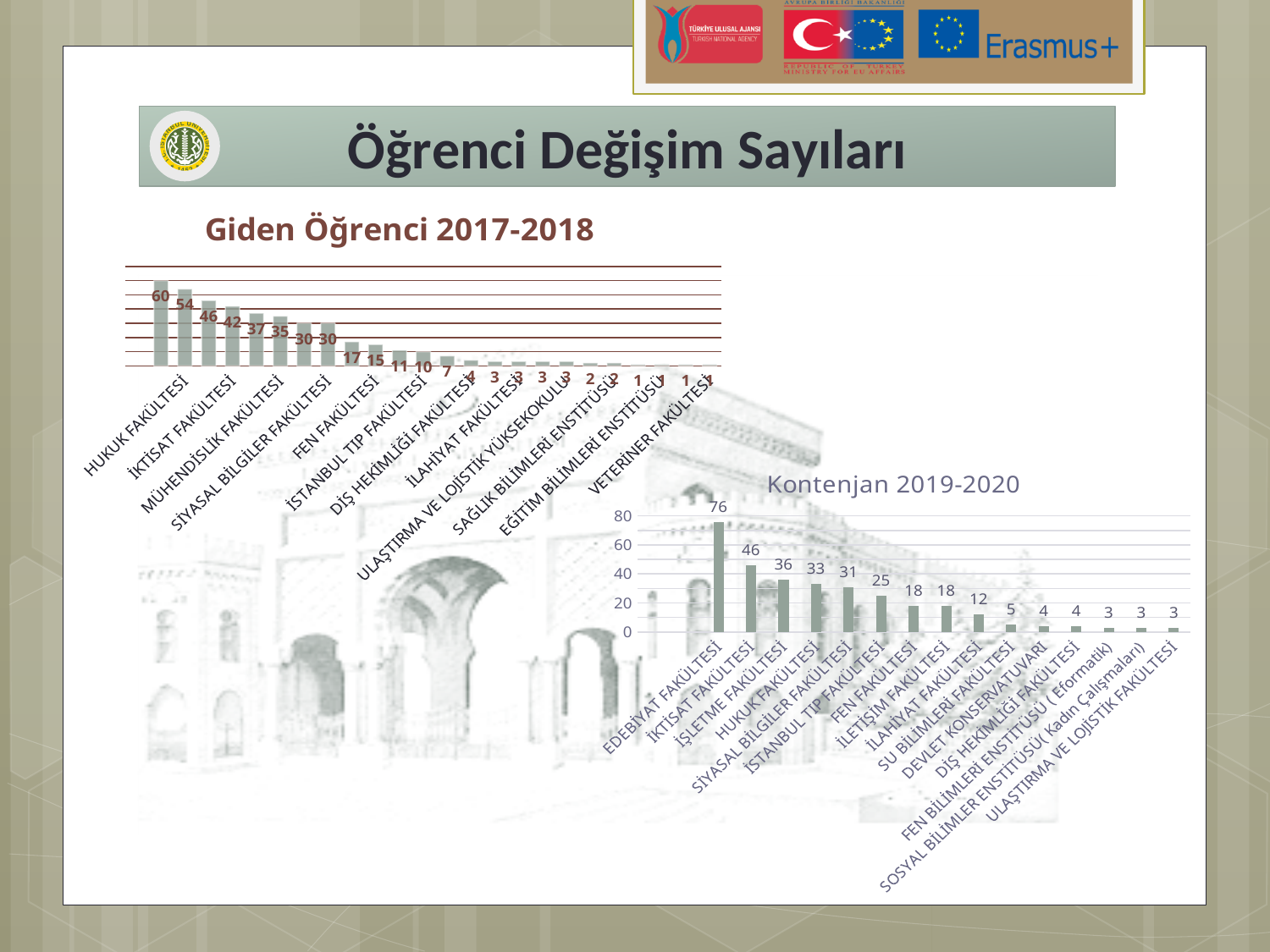
In the 'Kontenjan 2019-2020' chart, what is the difference between EDEBİYAT FAKÜLTESİ and İKTİSAT FAKÜLTESİ? 30 In the 'Kontenjan 2019-2020' chart, which category has the highest value? EDEBİYAT FAKÜLTESİ In the 'Kontenjan 2019-2020' chart, how many categories are plotted? 15 In the 'Kontenjan 2019-2020' chart, which is larger: İŞLETME FAKÜLTESİ or HUKUK FAKÜLTESİ? İŞLETME FAKÜLTESİ In the 'Kontenjan 2019-2020' chart, what is the value for EDEBİYAT FAKÜLTESİ? 76 What type of chart is the 'Kontenjan 2019-2020' chart? bar chart In the 'Kontenjan 2019-2020' chart, what is the value for İKTİSAT FAKÜLTESİ? 46 In the 'Kontenjan 2019-2020' chart, what is the value for İLAHİYAT FAKÜLTESİ? 12 In the 'Giden Öğrenci 2017-2018' chart, what is the highest value shown? 60 In the 'Kontenjan 2019-2020' chart, what is the value for İSTANBUL TIP FAKÜLTESİ? 25 In the 'Giden Öğrenci 2017-2018' chart, do the values rise or fall from left to right? fall